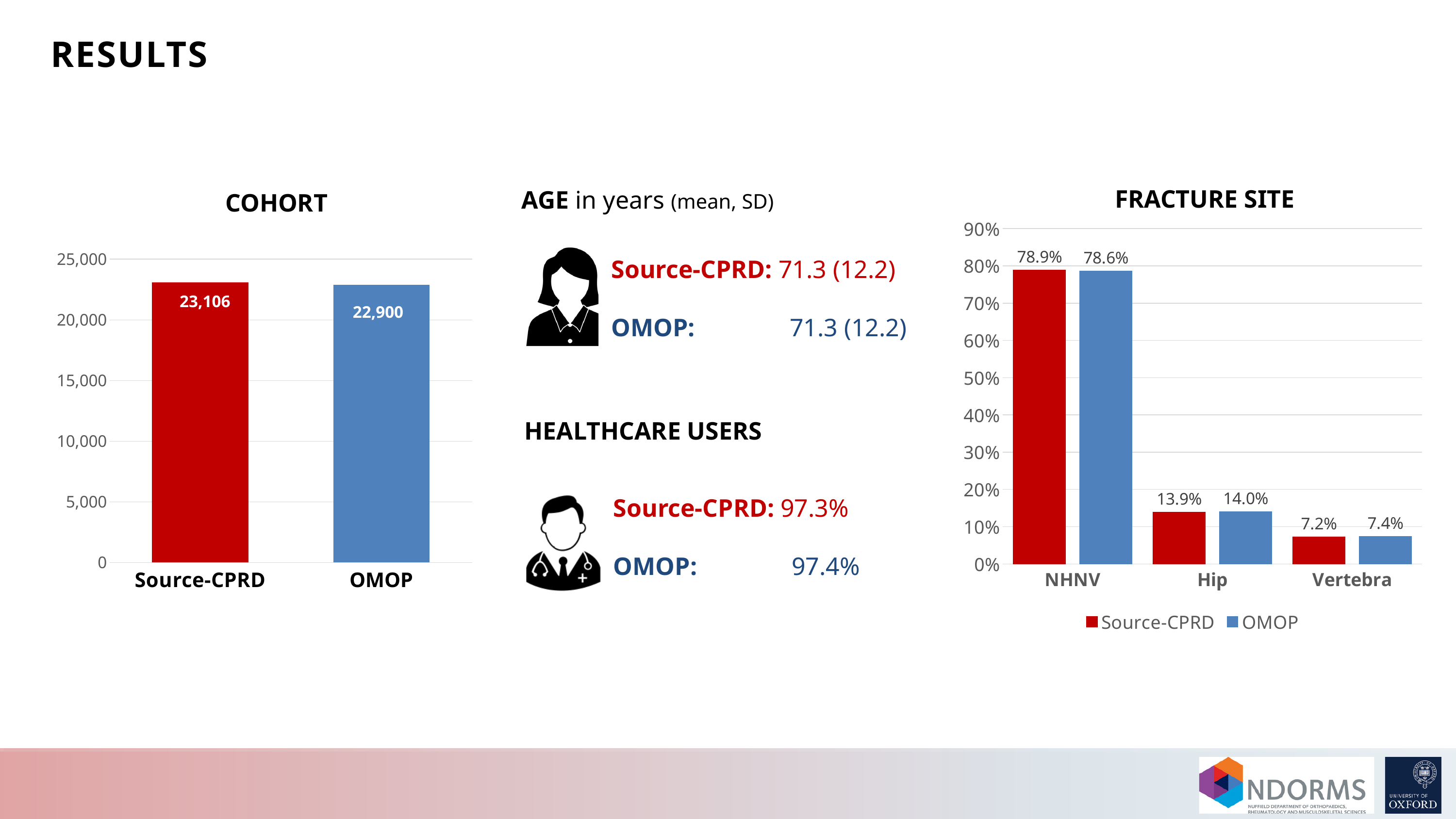
In the COHORT chart, what is the value for Source-CPRD? 23,106 In the FRACTURE SITE chart, what is the difference between the OMOP values for NHNV and Hip? 64.6% In the FRACTURE SITE chart, what is the Source-CPRD value for Vertebra? 7.2% In the COHORT chart, what is the difference between the Source-CPRD and OMOP values? 206 In the FRACTURE SITE chart, which fracture site has the lowest Source-CPRD value? Vertebra In the FRACTURE SITE chart, how many series does the legend list? 2 What kind of chart is the COHORT chart? Bar chart In the FRACTURE SITE chart, what is the Source-CPRD value for NHNV? 78.9% In the FRACTURE SITE chart, which fracture site has the highest OMOP value? NHNV In the FRACTURE SITE chart, what is the OMOP value for Hip? 14.0% In the COHORT chart, how many categories are shown on the x axis? 2 In the COHORT chart, what is the value for OMOP? 22,900